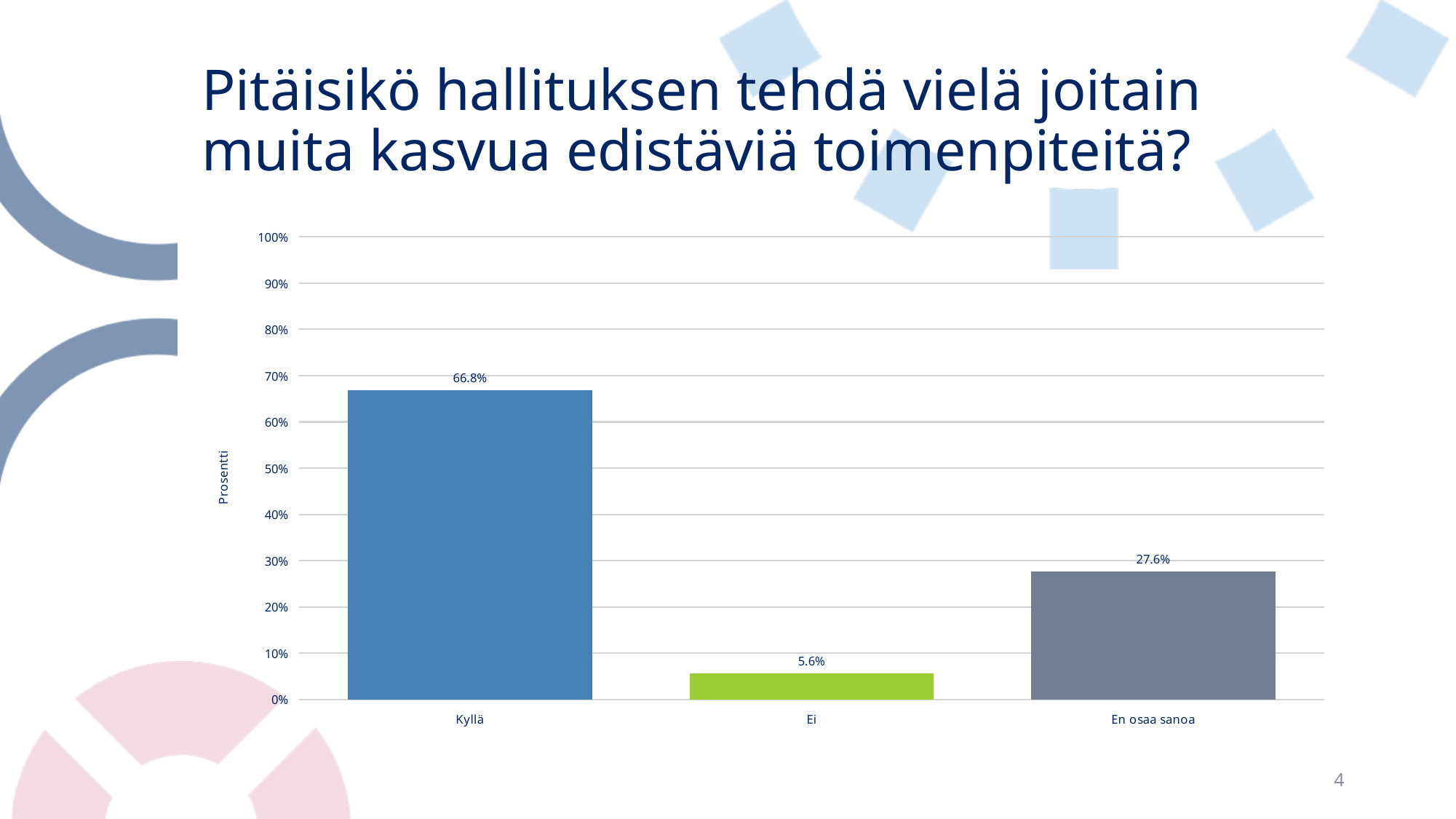
Which category has the highest value? Kyllä What is the value for Ei? 5.6% Is the value for Kyllä greater or less than 60%? greater What is the label of the vertical axis? Prosentti What kind of chart is shown on the slide? bar chart What is the value for Kyllä? 66.8% What is the difference between the values for En osaa sanoa and Ei? 22.0% How many categories are shown on the x axis? 3 What is the difference between the values for Kyllä and En osaa sanoa? 39.2% Which category has the lowest value? Ei What is the value for En osaa sanoa? 27.6% Which is larger, the value for Ei or the value for En osaa sanoa? En osaa sanoa